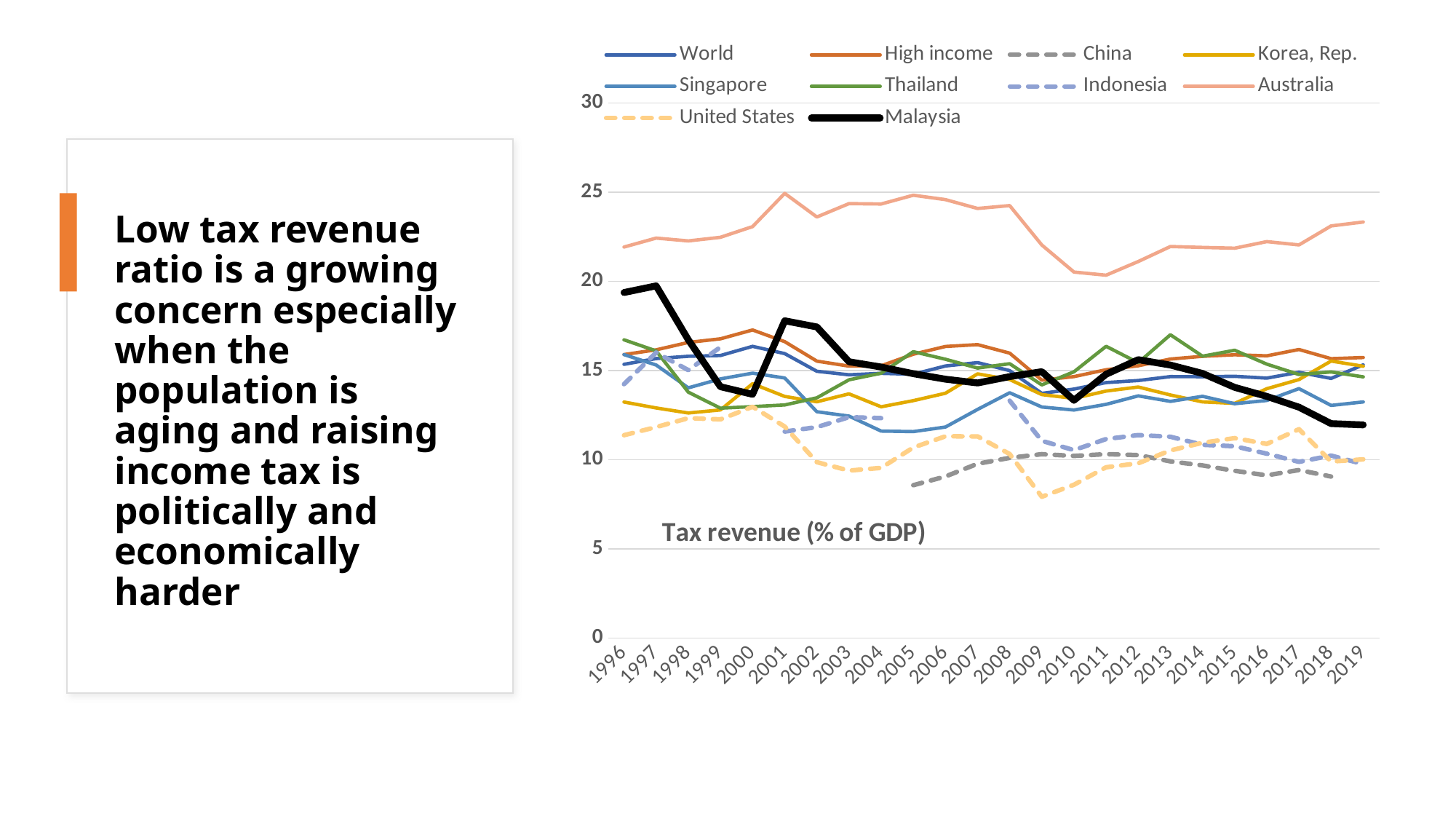
Which series has the lowest value in 2009? United States What kind of chart is shown on the slide? line chart Does the Malaysia line rise or fall overall from 1996 to 2019? fall Which is larger in 2019, the value for Malaysia or the value for the United States? Malaysia Is the value for China in 2005 greater or less than 10? less Is the value for Malaysia in 1996 greater or less than 15? greater Which series has the highest tax revenue (% of GDP) across the whole period? Australia How many series does the chart legend list? 10 Is the value for Australia in 2001 greater or less than 20? greater How many years are shown along the x axis of the chart? 24 What is the title shown inside the chart area? Tax revenue (% of GDP)